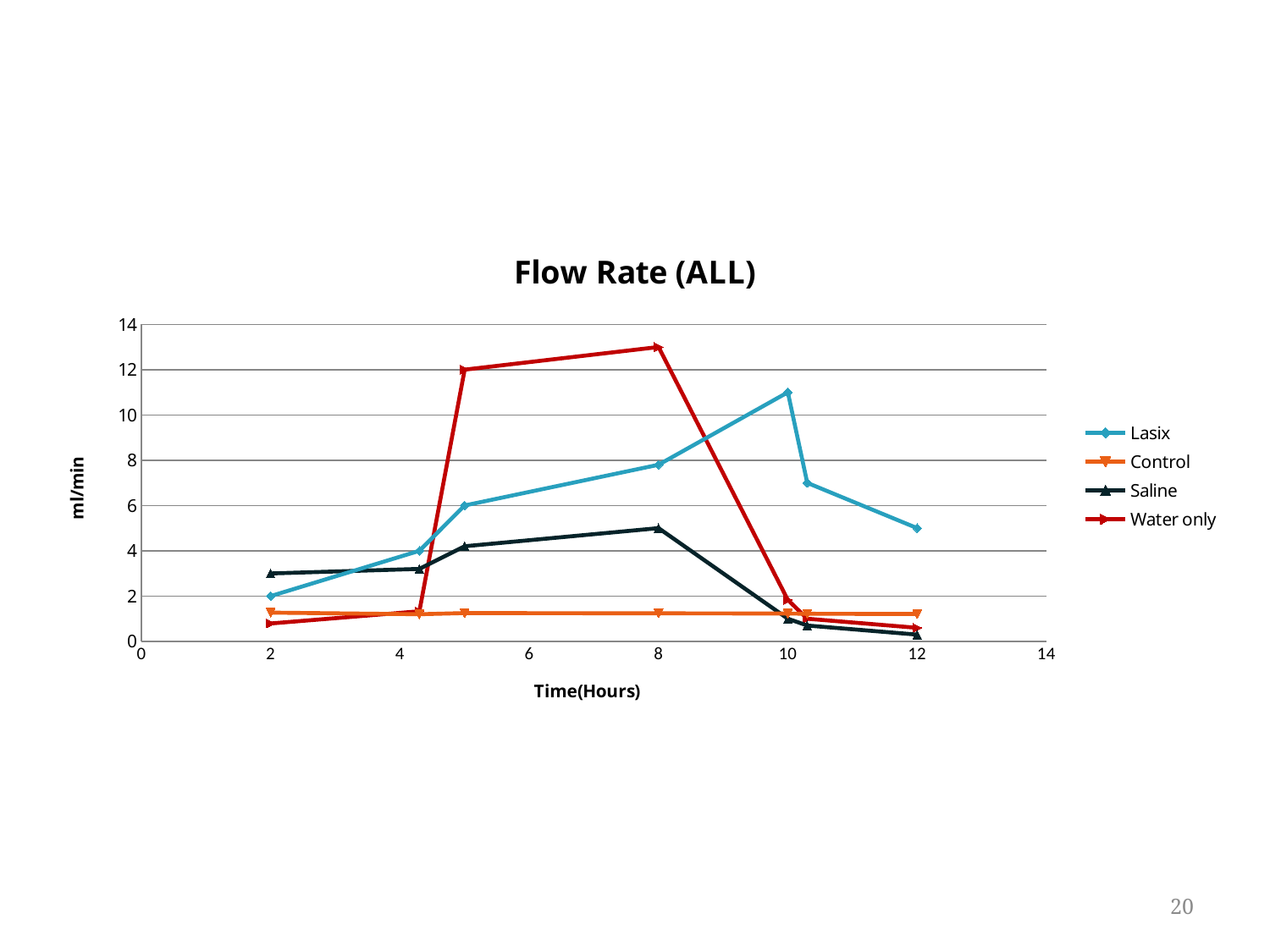
Is the Lasix value at 10 hours greater or less than 10? greater What is the Lasix value at 2 hours? 2 At 8 hours, which is larger, the Lasix value or the Saline value? Lasix Is the Water only value at 8 hours greater or less than 12? greater Does the Water only series rise or fall between 8 hours and 10 hours? fall How many series does the legend list? 4 What is the Water only value at 5 hours? 12 What is the Lasix value at 5 hours? 6 What is the title of the chart? Flow Rate (ALL) What type of chart is shown on the slide? line chart What is the label on the y axis? ml/min Which series reaches the highest value on the chart? Water only